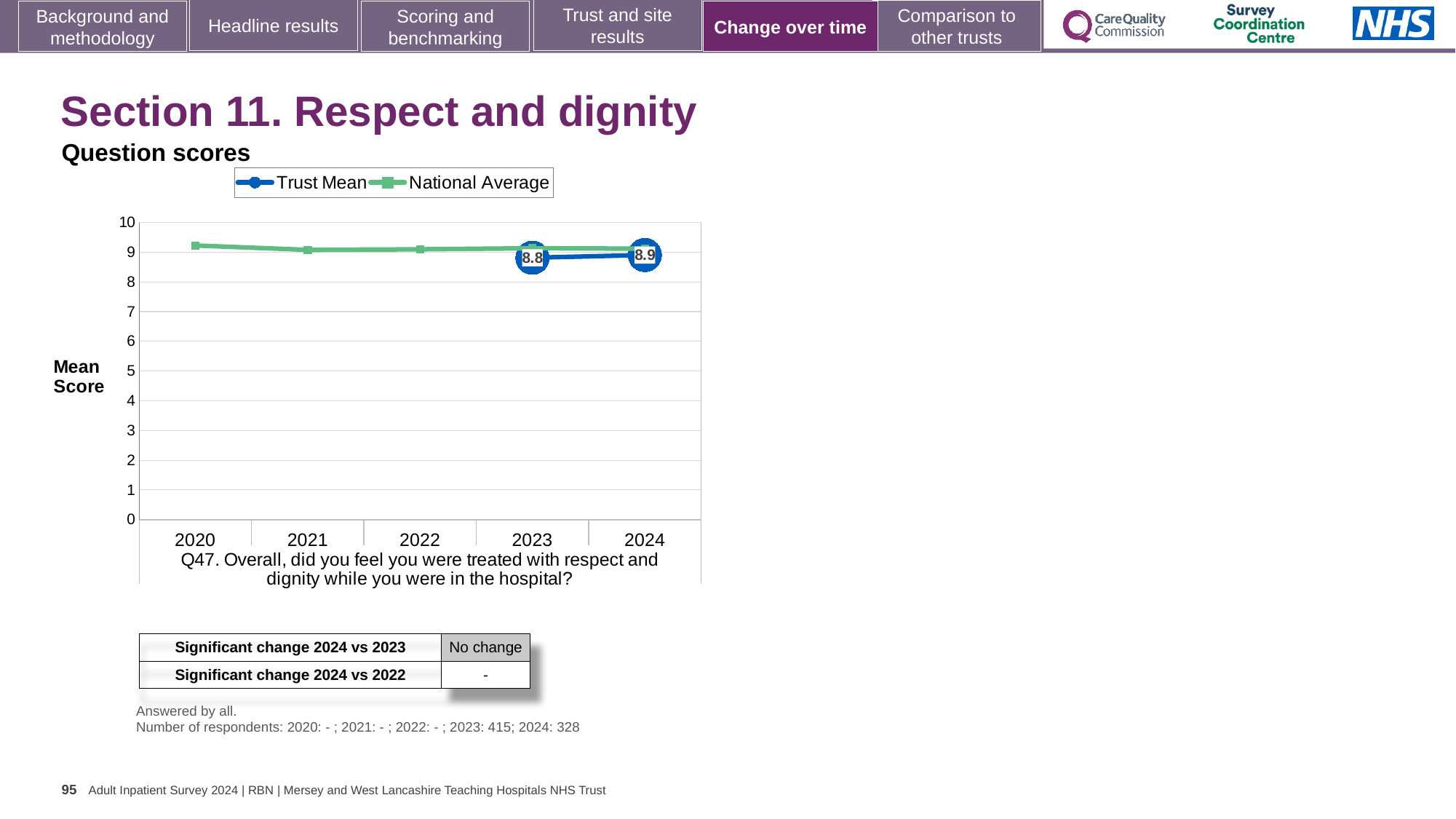
What is the Trust Mean value for 2024? 8.9 What is the difference between the Trust Mean values for 2024 and 2023? 0.1 How many data points are plotted for the Trust Mean series? 2 Is the National Average value for 2020 greater or less than 8? greater In 2023, which series has the higher value, Trust Mean or National Average? National Average What is the label on the y axis of the chart? Mean Score How many series does the legend list? 2 What is the Trust Mean value for 2023? 8.8 Which year has the higher Trust Mean value, 2023 or 2024? 2024 What kind of chart is shown on the slide? Line chart How many years are shown on the x axis? 5 Does the Trust Mean rise or fall from 2023 to 2024? rise